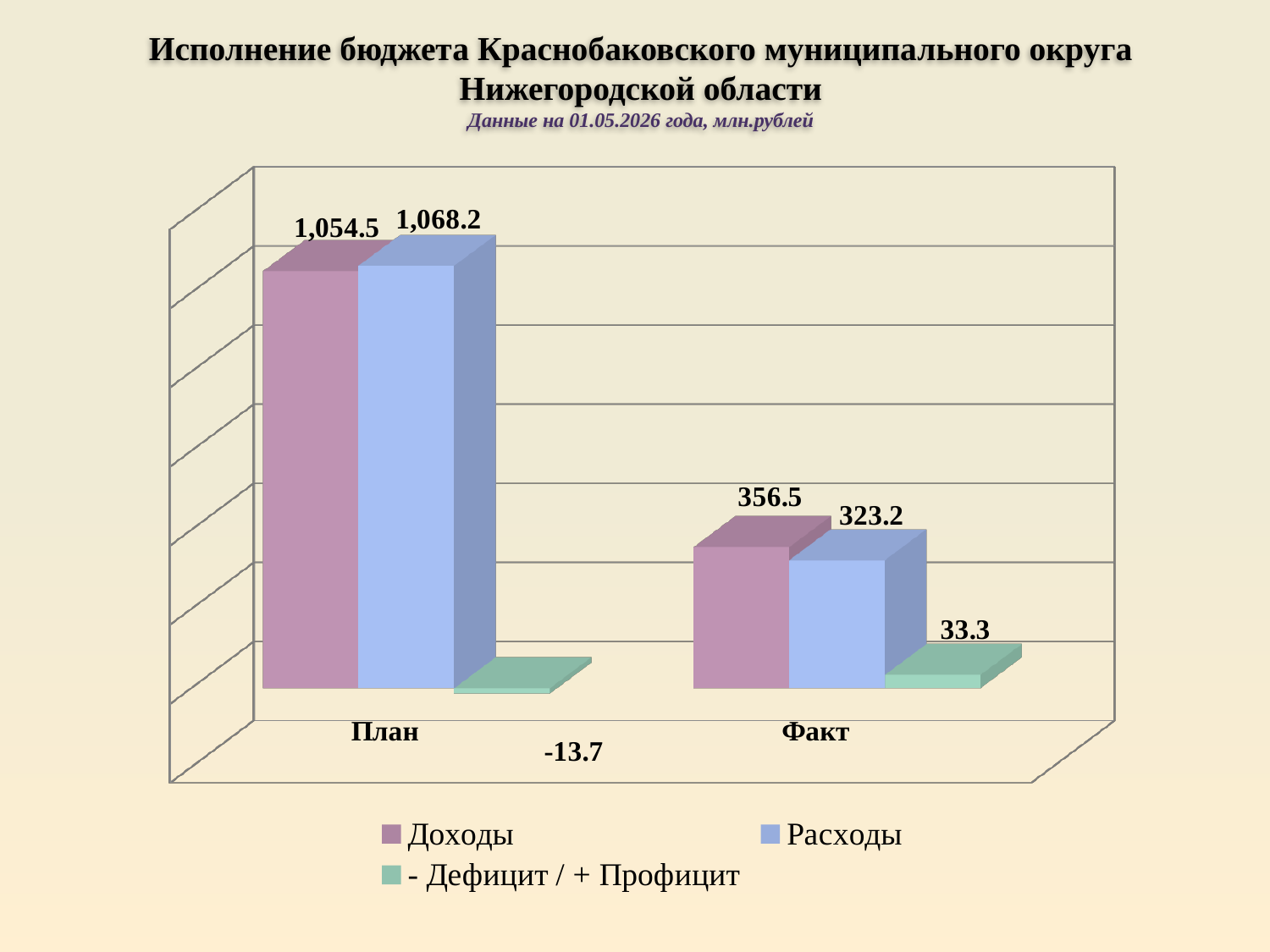
What is the value of the - Дефицит / + Профицит series for Факт? 33.3 How many categories are shown on the x axis? 2 What is the difference between Расходы and Доходы for План? 13.7 Which series has the lowest value for Факт? - Дефицит / + Профицит How many series does the legend list? 3 What is the value of Доходы for План? 1,054.5 Which series has the highest value for План? Расходы What is the value of Расходы for Факт? 323.2 What kind of chart is shown on the slide? Bar chart What is the difference between Доходы for План and Доходы for Факт? 698.0 What is the value of the - Дефицит / + Профицит series for План? -13.7 Which is larger for Факт: Доходы or Расходы? Доходы